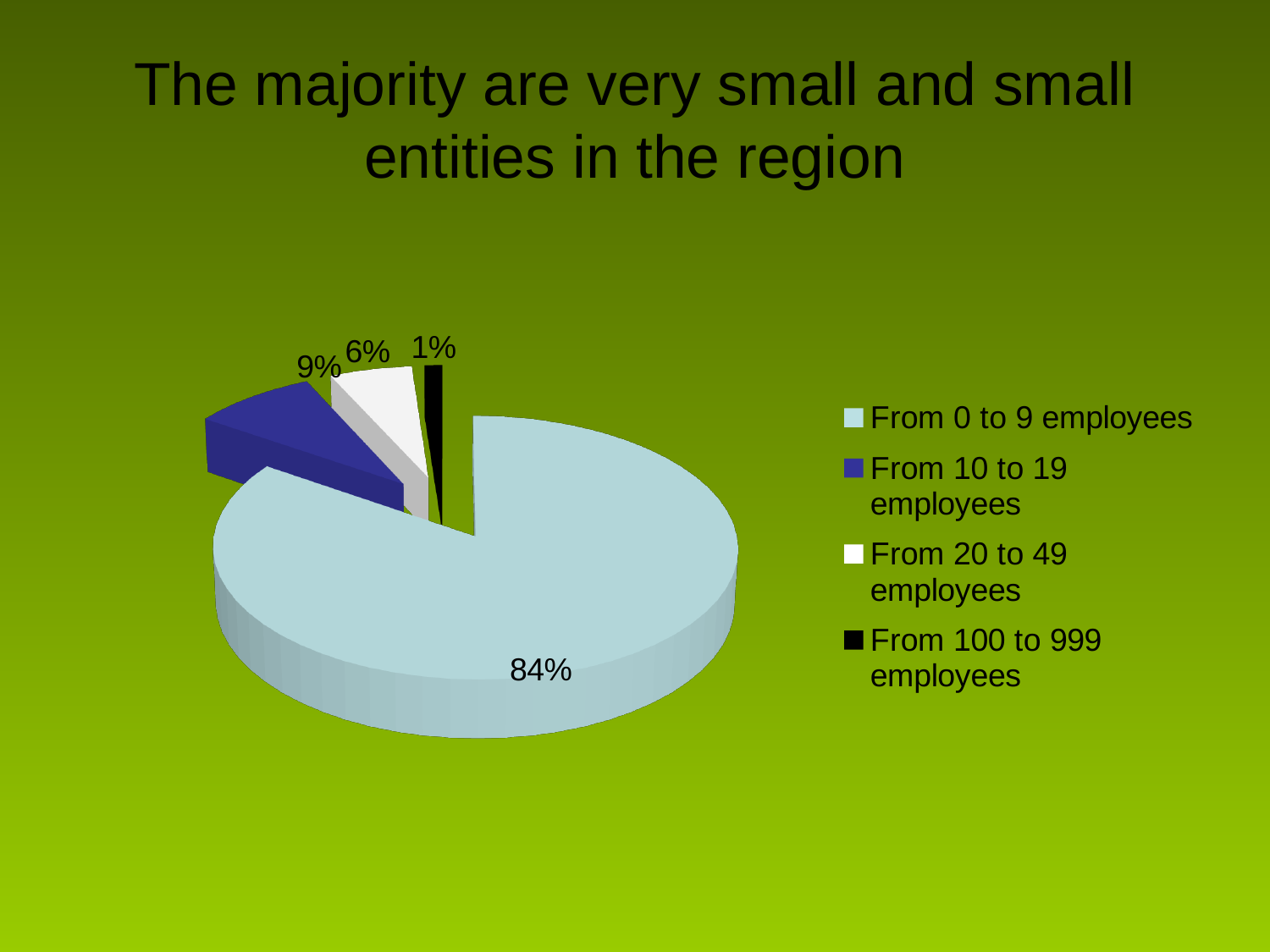
Which slice is larger: 'From 10 to 19 employees' or 'From 20 to 49 employees'? From 10 to 19 employees How many categories does the pie chart show? 4 What share of the pie is labelled for 'From 0 to 9 employees'? 84% What share of the pie is labelled for 'From 20 to 49 employees'? 6% What kind of chart is shown on the slide? Pie chart What share of the pie is labelled for 'From 10 to 19 employees'? 9% What colour is the slice for 'From 100 to 999 employees'? Black What is the difference in percentage points between the 'From 0 to 9 employees' slice and the 'From 10 to 19 employees' slice? 75 Which category has the smallest slice of the pie? From 100 to 999 employees What is the combined share of the 'From 10 to 19 employees' and 'From 20 to 49 employees' slices? 15% What share of the pie is labelled for 'From 100 to 999 employees'? 1% Which category has the largest slice of the pie? From 0 to 9 employees